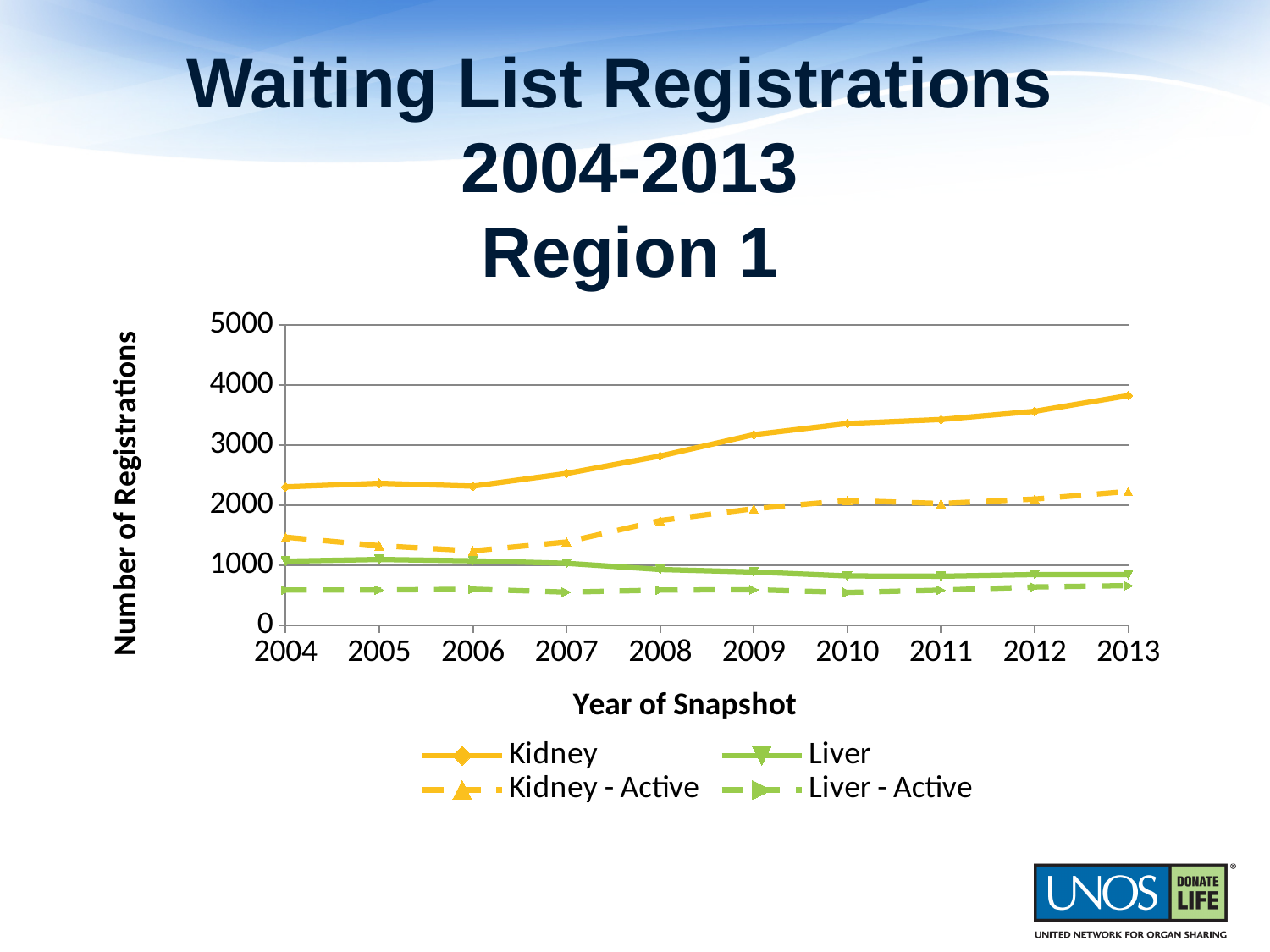
In which year is the Kidney series at its highest? 2013 Does the Liver series generally rise or fall from 2004 to 2013? Fall Is the value for Liver - Active in 2010 greater or less than 1000? less How many years are plotted along the x axis? 10 Which is larger in 2010, the Kidney value or the Liver value? Kidney Is the value for Kidney in 2013 greater or less than 3000? greater How many series does the legend list? 4 What is the title of the y axis? Number of Registrations What kind of chart is shown on the slide? Line chart Does the Kidney series generally rise or fall from 2004 to 2013? Rise Is the value for Kidney - Active in 2008 greater or less than 1000? greater